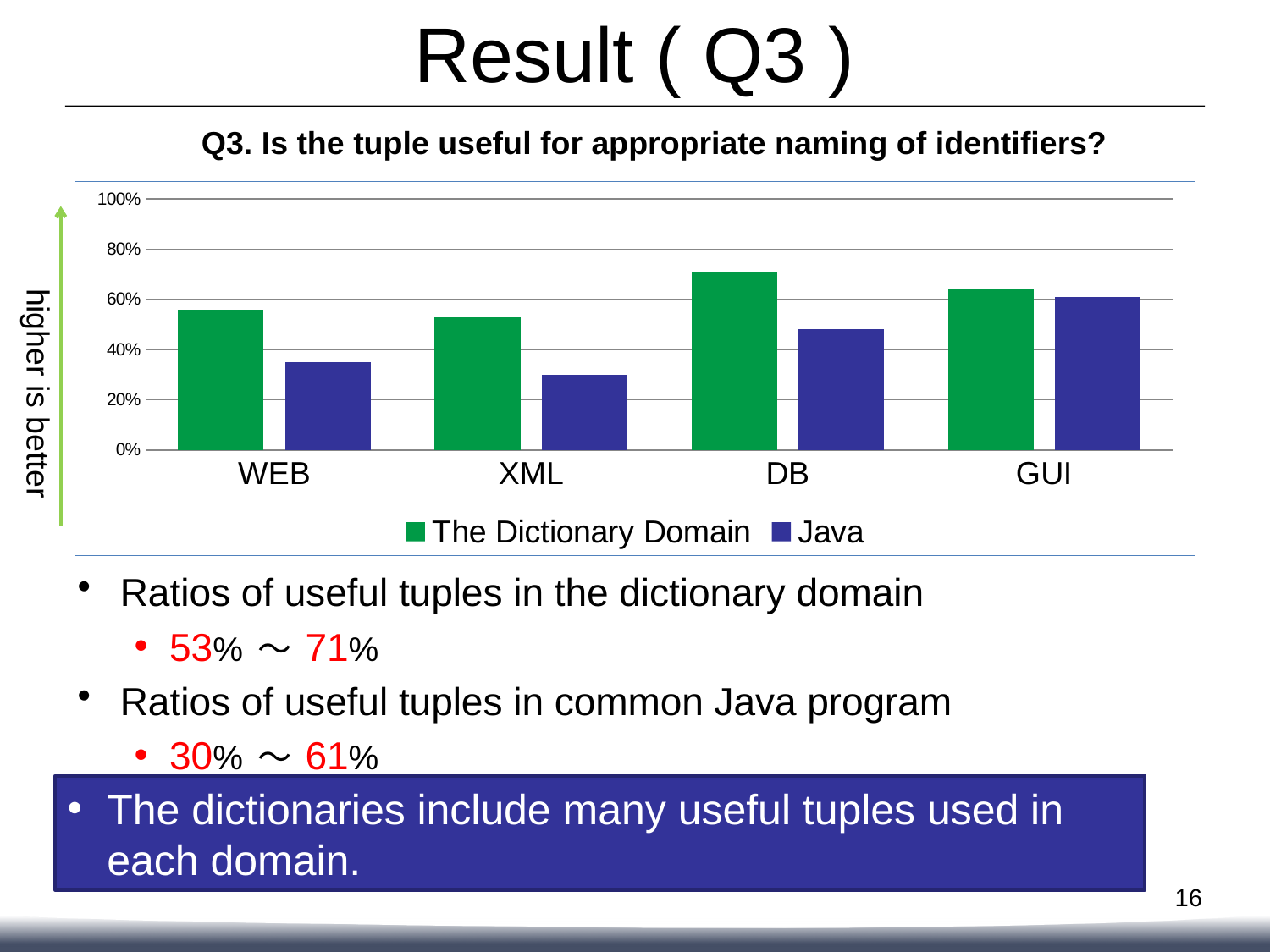
Is the value for Java in GUI greater or less than 40%? greater Which category has the highest value for the Java series? GUI How many series does the chart legend list? 2 What kind of chart is shown on the slide? bar chart Which category has the highest value for The Dictionary Domain series? DB Which category has the lowest value for the Java series? XML Is the value for Java in XML greater or less than 40%? less In the WEB category, which series has the larger value, The Dictionary Domain or Java? The Dictionary Domain How many categories are shown on the x axis of the chart? 4 Is the value for The Dictionary Domain in DB greater or less than 60%? greater What colour are the bars for the Java series? blue